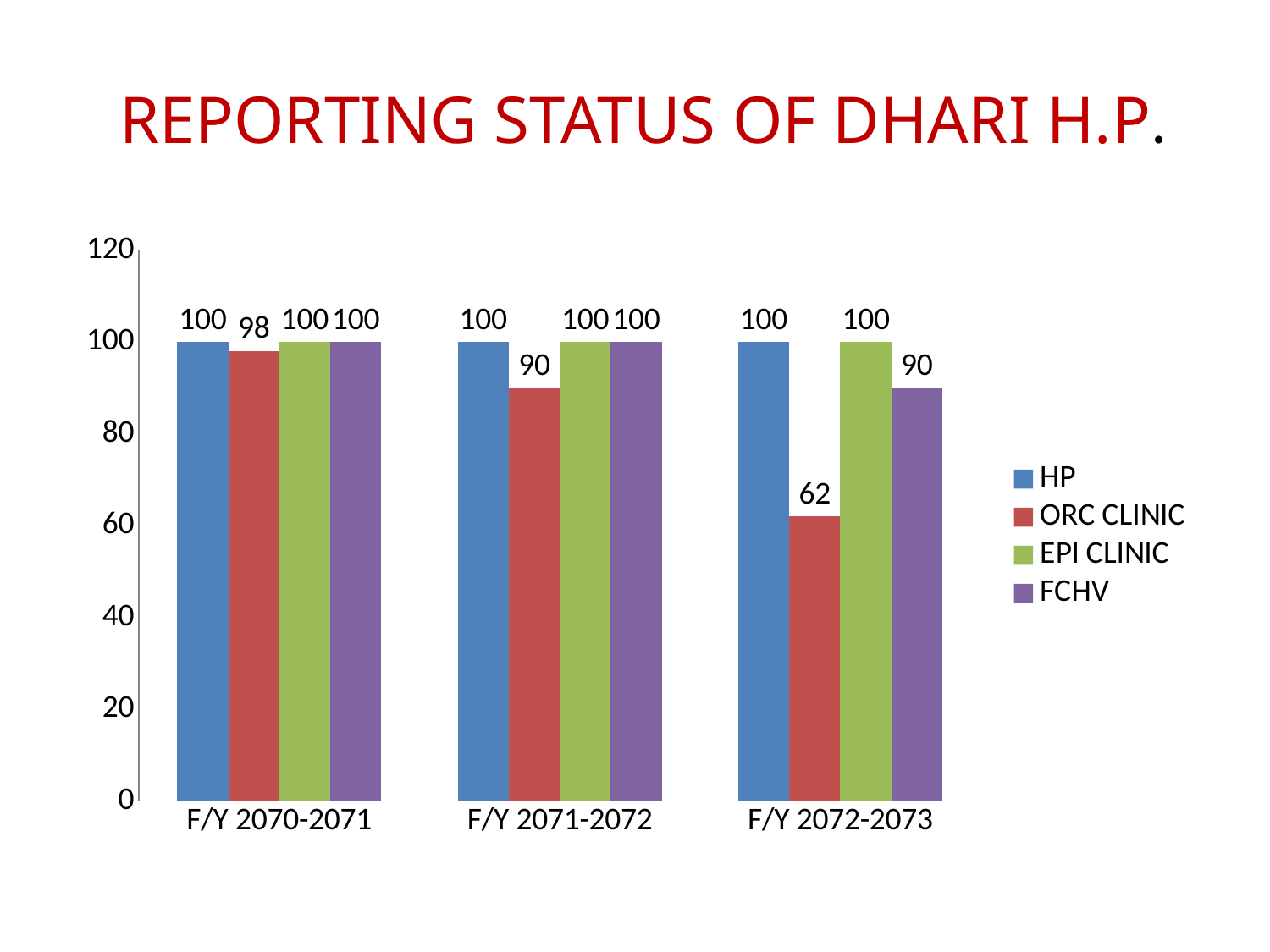
Which is larger in F/Y 2072-2073, the FCHV value or the ORC CLINIC value? FCHV What is the value for ORC CLINIC in F/Y 2070-2071? 98 Which series has the lowest value in F/Y 2072-2073? ORC CLINIC What is the value for ORC CLINIC in F/Y 2072-2073? 62 What is the difference between the HP value and the ORC CLINIC value in F/Y 2072-2073? 38 What is the value for ORC CLINIC in F/Y 2071-2072? 90 What is the difference between the ORC CLINIC values in F/Y 2070-2071 and F/Y 2072-2073? 36 What is the value for FCHV in F/Y 2072-2073? 90 What kind of chart is shown on the slide? Bar chart How many series does the legend list? 4 Is the value for ORC CLINIC in F/Y 2072-2073 greater or less than 80? less How many fiscal year categories are shown on the x axis? 3